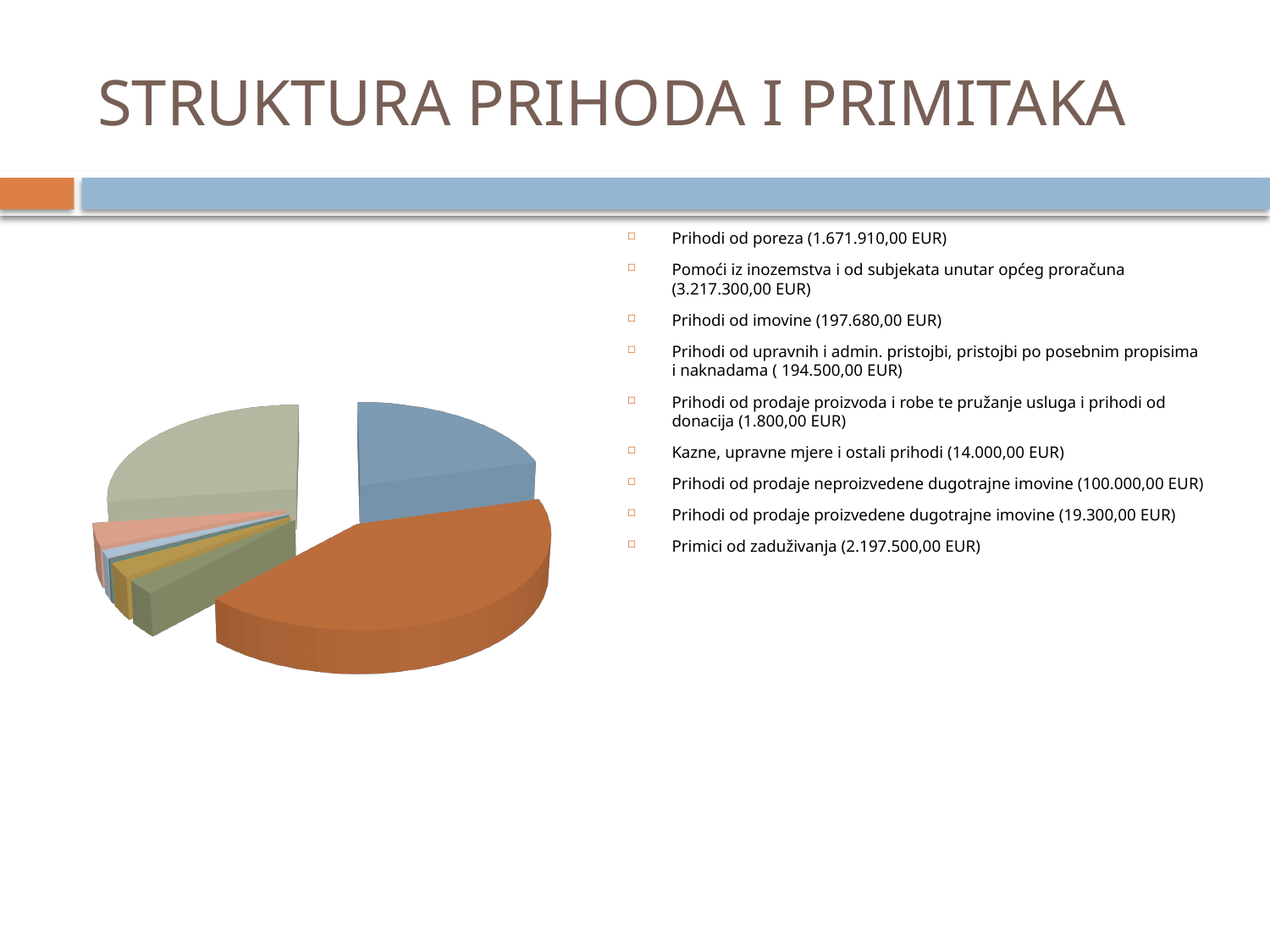
Which category has the lowest value? Prihodi od prodaje proizvoda i robe te pružanje usluga i prihodi od donacija What is the value for Prihodi od poreza? 1.671.910,00 EUR What is the value for Kazne, upravne mjere i ostali prihodi? 14.000,00 EUR What colour is the largest slice of the pie chart? Orange How many revenue categories are listed next to the pie chart? 9 What is the difference between Prihodi od prodaje neproizvedene dugotrajne imovine and Prihodi od prodaje proizvedene dugotrajne imovine? 80.700,00 EUR Which category has the highest value? Pomoći iz inozemstva i od subjekata unutar općeg proračuna What is the value for Primici od zaduživanja? 2.197.500,00 EUR What kind of chart is shown on the slide? Pie chart What is the difference between Primici od zaduživanja and Prihodi od poreza? 525.590,00 EUR Which is larger: Prihodi od imovine or Prihodi od upravnih i admin. pristojbi, pristojbi po posebnim propisima i naknadama? Prihodi od imovine What is the title of the slide containing the pie chart? STRUKTURA PRIHODA I PRIMITAKA